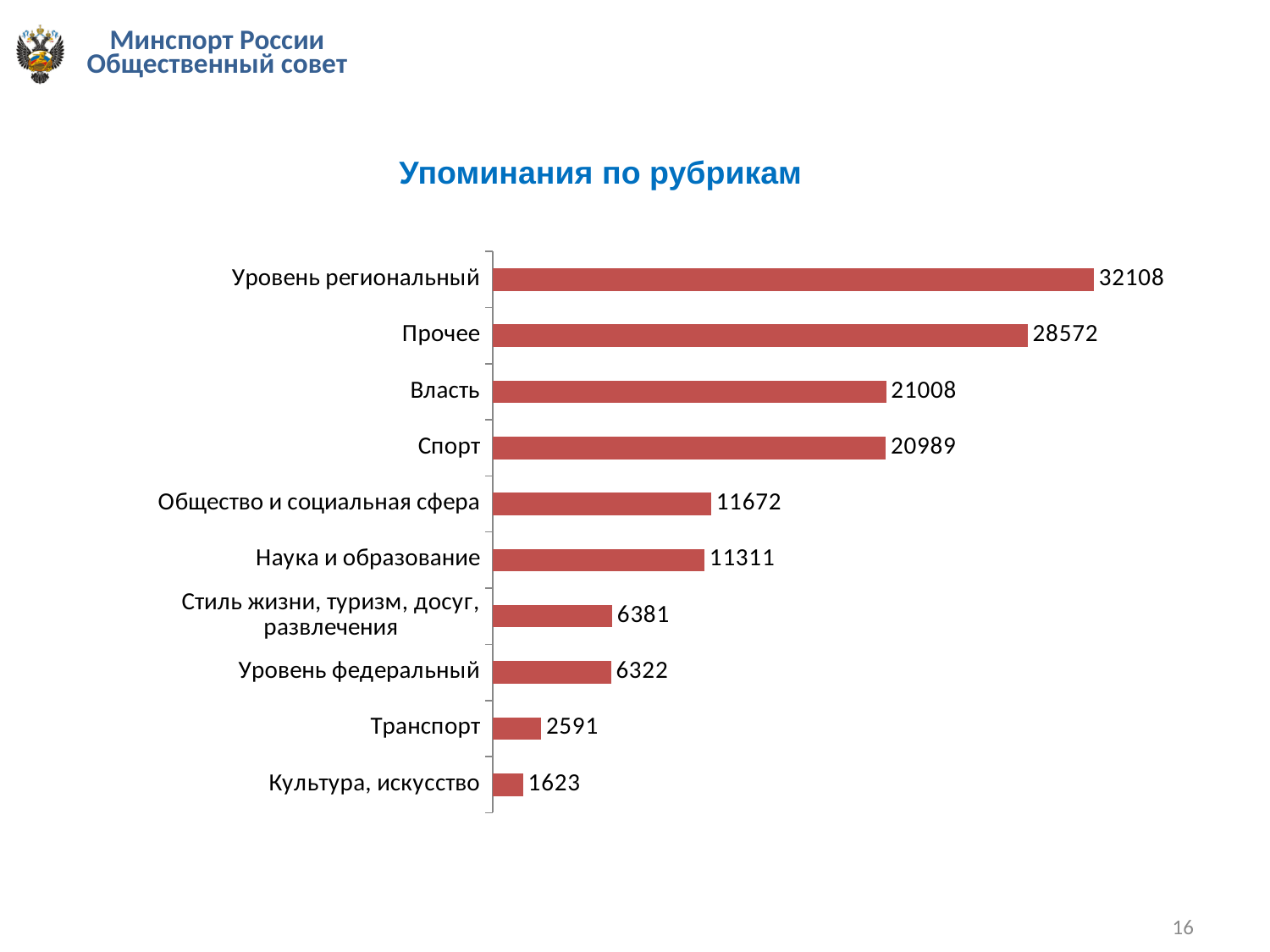
What kind of chart is shown on the slide? Bar chart What is the value for Транспорт? 2591 Which is larger, the value for Общество и социальная сфера or the value for Уровень федеральный? Общество и социальная сфера How many categories are shown in the chart? 10 What is the value for Стиль жизни, туризм, досуг, развлечения? 6381 What is the value for Наука и образование? 11311 What is the value for Уровень региональный? 32108 Which category has the lowest value? Культура, искусство What is the title of the chart? Упоминания по рубрикам What is the difference between the values for Уровень региональный and Прочее? 3536 Which category has the highest value? Уровень региональный What is the difference between the values for Власть and Спорт? 19